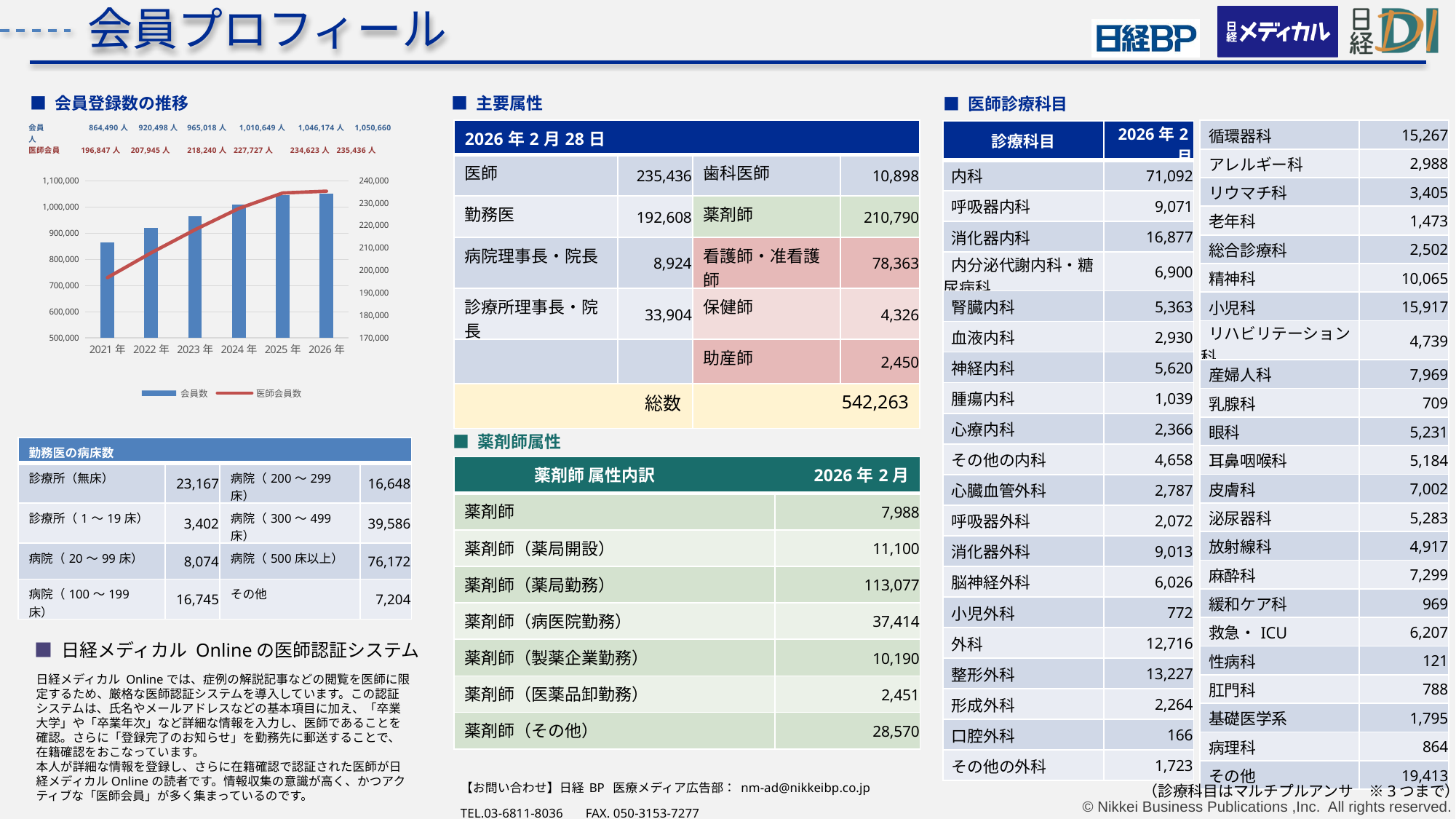
In the 会員登録数の推移 chart, what is the 会員数 value for 2021年? 864,490人 In the 会員登録数の推移 chart, what is the 会員数 value for 2024年? 1,010,649人 In the 会員登録数の推移 chart, which year has the lowest 医師会員 value? 2021年 In the 会員登録数の推移 chart, which year has the highest 会員数? 2026年 In the 会員登録数の推移 chart, what is the difference between the 会員数 for 2026年 and 2021年? 186,170 What kind of chart is the 会員登録数の推移 chart? A bar chart combined with a line How many series does the legend of the 会員登録数の推移 chart list? 2 How many years are shown on the x axis of the 会員登録数の推移 chart? 6 In the 会員登録数の推移 chart, does the 会員数 rise or fall from 2021年 to 2026年? rise In the 会員登録数の推移 chart, is the 会員数 bar for 2021年 greater or less than 900,000? less In the 会員登録数の推移 chart, what is the 医師会員 value for 2026年? 235,436人 In the 会員登録数の推移 chart, what is the 医師会員 value for 2023年? 218,240人